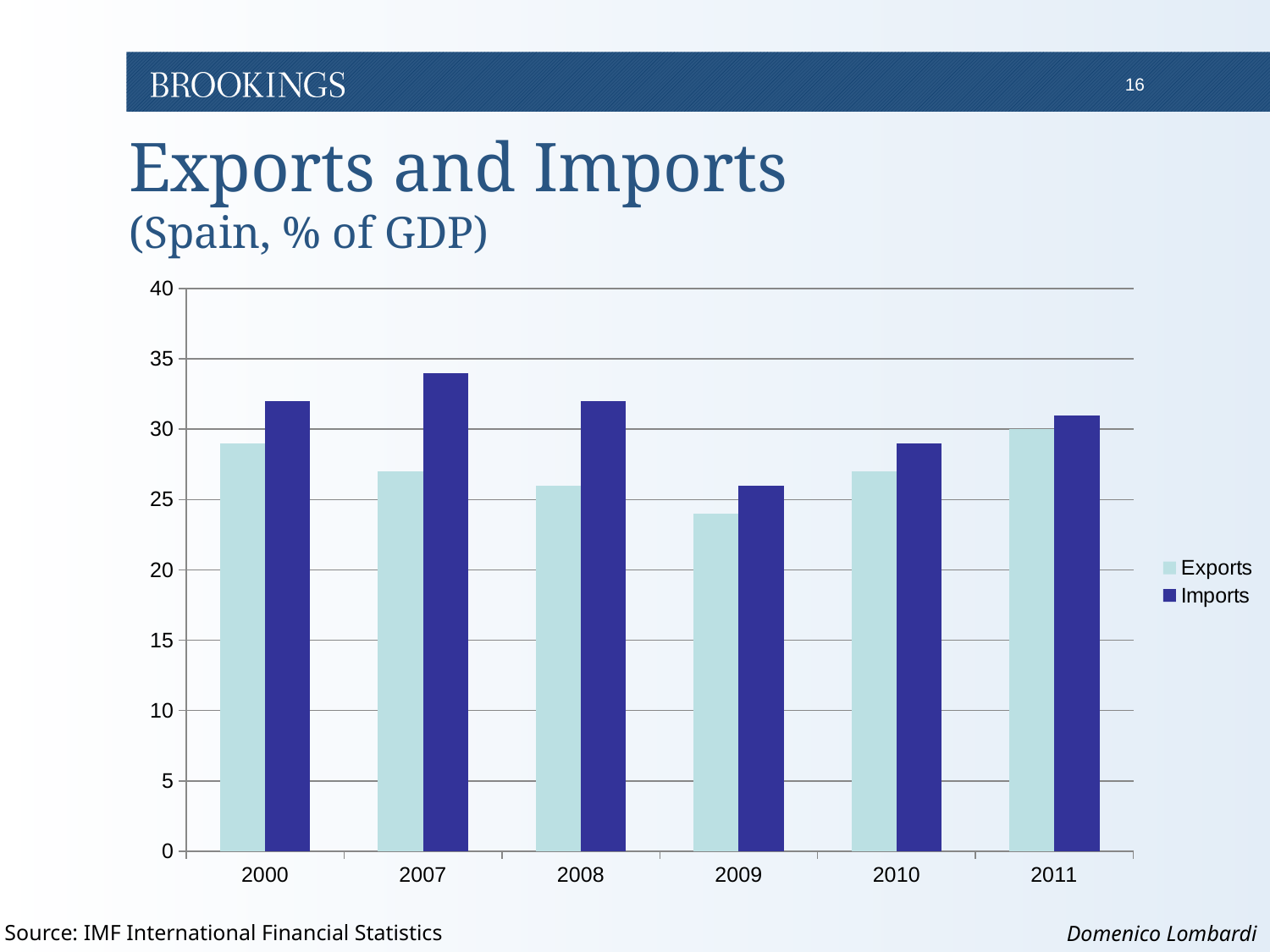
Do Exports rise or fall from 2007 to 2009? Fall What kind of chart is shown on the slide? Bar chart How many series does the legend list? 2 Is the value for Exports in 2009 greater or less than 25? less Is the value for Imports in 2007 greater or less than 30? greater In which year are Imports lowest? 2009 In which year are Imports highest? 2007 In which year are Exports lowest? 2009 How many years are shown on the x axis? 6 In 2007, which is larger, Exports or Imports? Imports Is the value for Exports in 2010 greater or less than 30? less What are the two entries in the legend? Exports and Imports